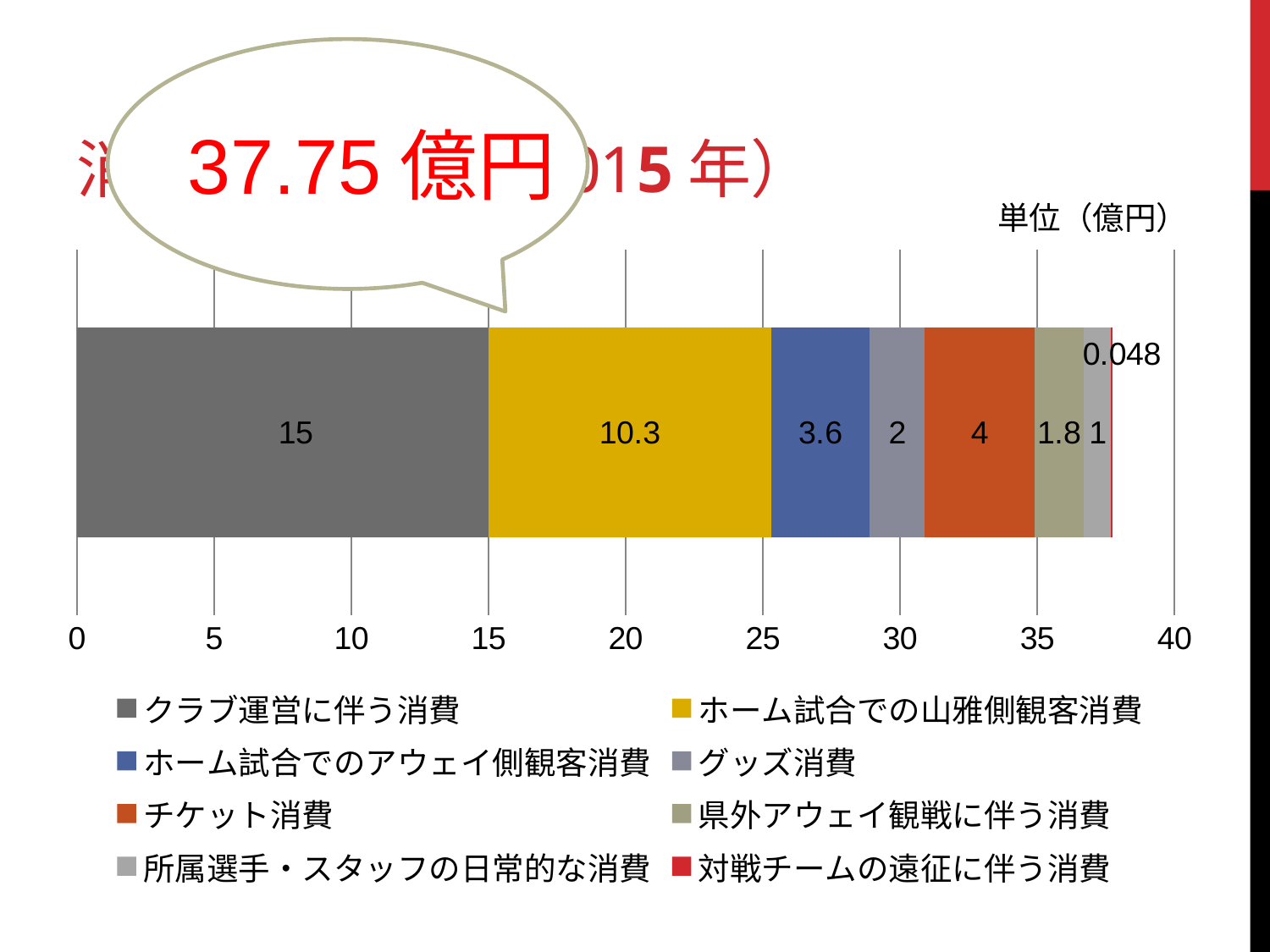
What is the value for 対戦チームの遠征に伴う消費? 0.048 What unit is stated for the values in the chart? 億円 What is the value for クラブ運営に伴う消費? 15 Which is larger, ホーム試合でのアウェイ側観客消費 or チケット消費? チケット消費 Which segment of the bar is the smallest? 対戦チームの遠征に伴う消費 What is the difference between クラブ運営に伴う消費 and ホーム試合での山雅側観客消費? 4.7 What kind of chart is shown on the slide? Stacked bar chart Which segment of the bar is the largest? クラブ運営に伴う消費 How many series does the legend list? 8 What is the value for ホーム試合での山雅側観客消費? 10.3 What is the total of the stacked bar, as shown in the callout on the slide? 37.75 億円 What is the value for チケット消費? 4